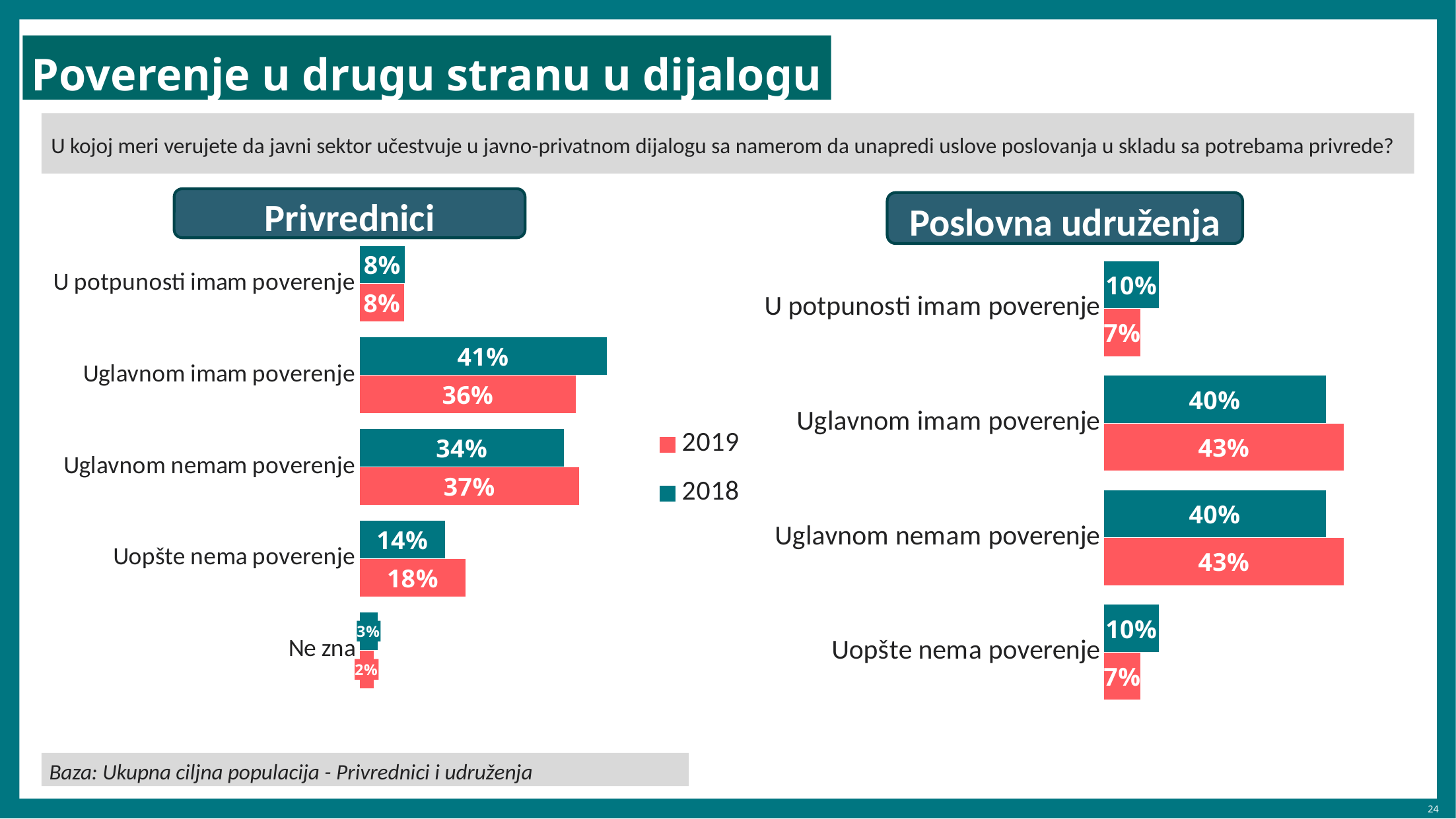
In the Privrednici chart, what is the 2018 value for Uopšte nema poverenje? 14% In the Privrednici chart, what is the 2019 value for Uglavnom imam poverenje? 36% In the Poslovna udruženja chart, what is the 2018 value for Uglavnom nemam poverenje? 40% In the Privrednici chart, what is the difference between the 2019 and 2018 values for Uopšte nema poverenje? 4% In the Privrednici chart, which is larger for Uglavnom nemam poverenje: the 2018 value or the 2019 value? 2019 How many categories does the Privrednici chart show? 5 What type of chart is the Poslovna udruženja chart? Bar chart In the Privrednici chart, which category has the highest 2018 value? Uglavnom imam poverenje How many series does the legend list? 2 In the Poslovna udruženja chart, what is the difference between the 2019 and 2018 values for Uglavnom imam poverenje? 3% In the Poslovna udruženja chart, what is the 2019 value for U potpunosti imam poverenje? 7% In the Privrednici chart, which category has the lowest 2019 value? Ne zna